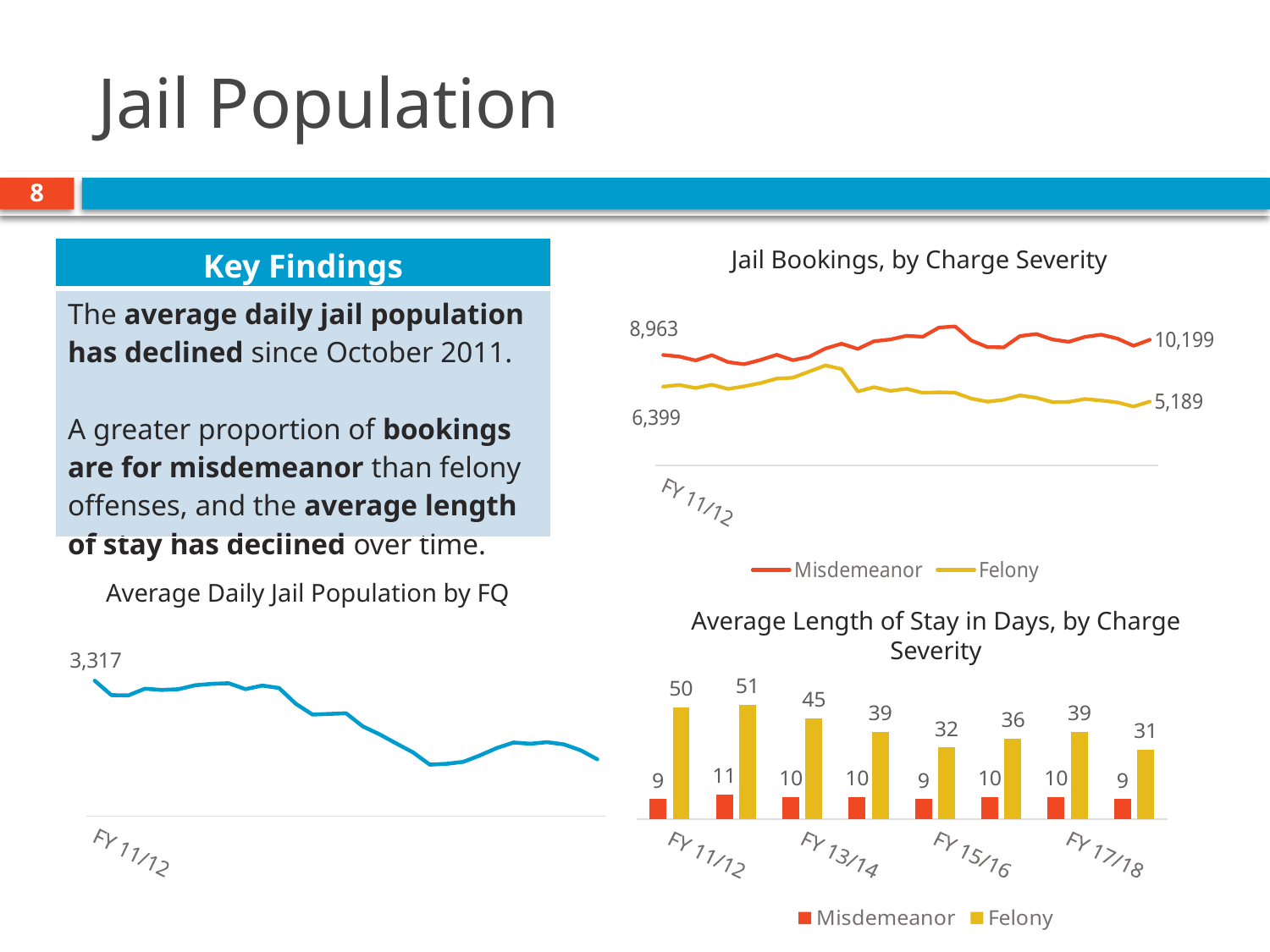
In the 'Average Length of Stay in Days, by Charge Severity' chart, what is the Misdemeanor value for FY 13/14? 10 In the 'Average Length of Stay in Days, by Charge Severity' chart, what is the difference between the Felony and Misdemeanor values for FY 11/12? 41 How many series does the legend of the 'Jail Bookings, by Charge Severity' chart list? 2 In the 'Jail Bookings, by Charge Severity' chart, what is the difference between the final Misdemeanor value (10,199) and the final Felony value (5,189)? 5,010 What kind of chart is the 'Jail Bookings, by Charge Severity' chart? line chart In the 'Average Daily Jail Population by FQ' chart, do the values generally rise or fall along the x axis? fall In the 'Average Length of Stay in Days, by Charge Severity' chart, what is the Felony value for FY 17/18? 39 In the 'Average Length of Stay in Days, by Charge Severity' chart, what is the lowest Felony value shown? 31 In the 'Jail Bookings, by Charge Severity' chart, what is the last labelled value of the Misdemeanor line? 10,199 What kind of chart is the 'Average Length of Stay in Days, by Charge Severity' chart? bar chart In the 'Average Length of Stay in Days, by Charge Severity' chart, what is the highest Felony value shown? 51 In the 'Average Length of Stay in Days, by Charge Severity' chart, what is the Felony value for FY 11/12? 50